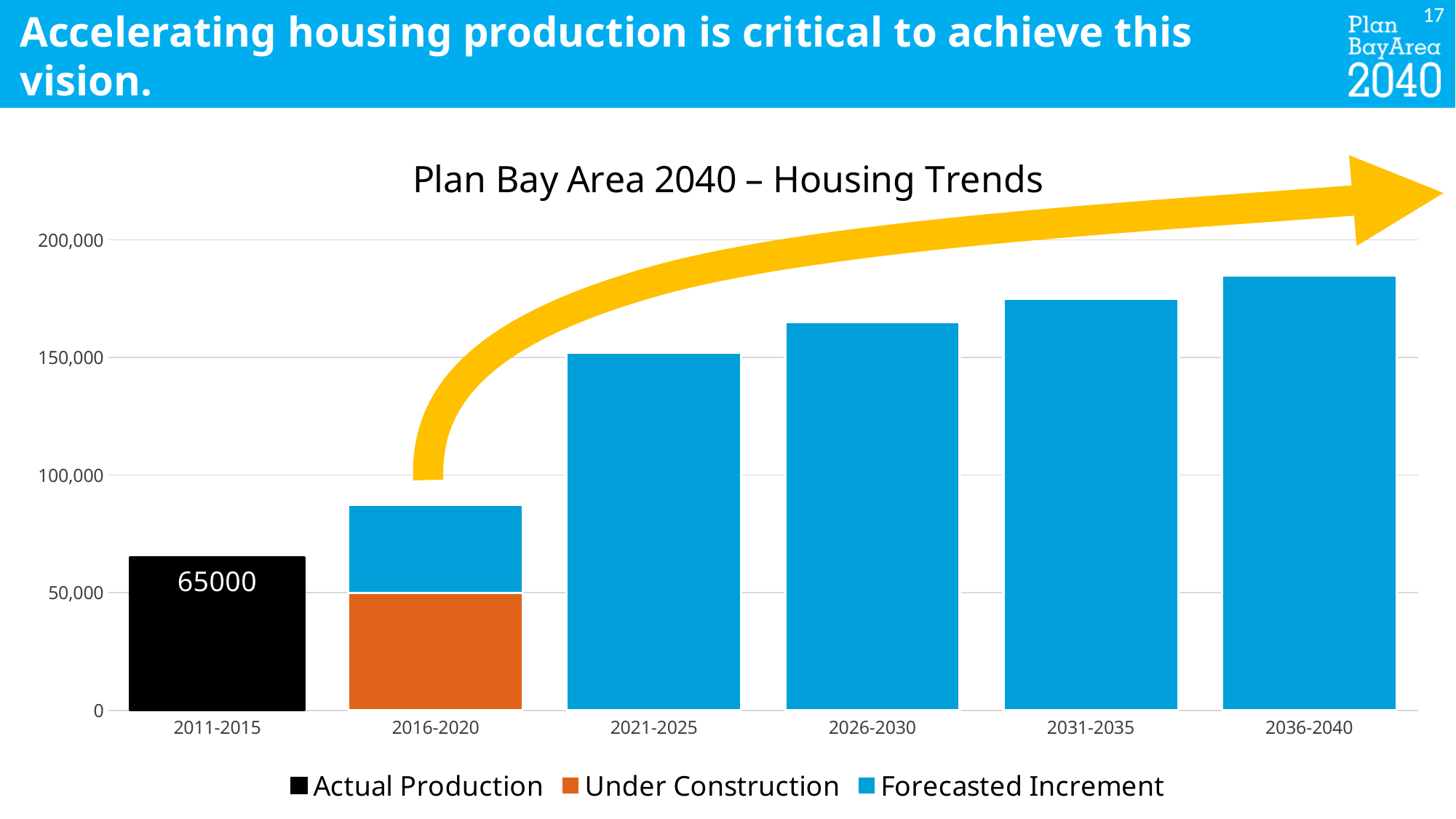
Is the total for 2026-2030 greater or less than 150,000? greater Is the total for 2016-2020 greater or less than 100,000? less How many series does the legend list? 3 What is the title of the chart? Plan Bay Area 2040 – Housing Trends Is the Forecasted Increment portion for 2016-2020 greater or less than 50,000? less Which period has the tallest bar? 2036-2040 What kind of chart is shown on the slide? Bar chart How many time periods are shown on the x axis? 6 Do the bar totals rise or fall from 2011-2015 to 2036-2040? rise What is the value of Actual Production for 2011-2015? 65000 Which period has the shortest bar? 2011-2015 Which bar is taller, 2031-2035 or 2021-2025? 2031-2035